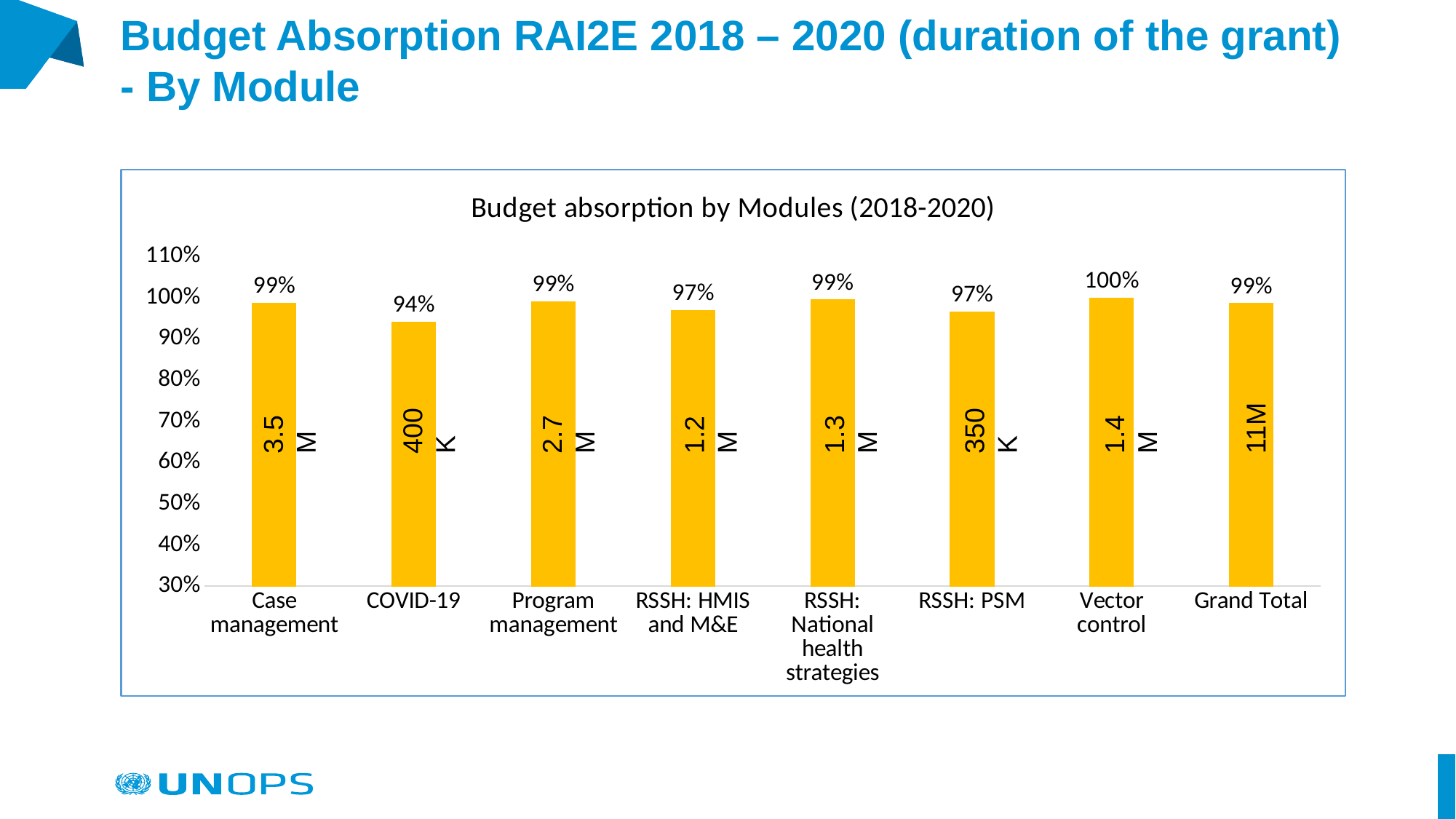
What is the budget absorption percentage for the Grand Total? 99% What is the difference in budget absorption percentage between Vector control and COVID-19? 6% How many categories are shown on the x axis of the chart? 8 Which module has the lowest budget absorption percentage? COVID-19 What is the budget absorption percentage for RSSH: PSM? 97% What is the title of the chart? Budget absorption by Modules (2018-2020) What is the budget absorption percentage for COVID-19? 94% Which category has the highest budget absorption percentage? Vector control Is the budget absorption for COVID-19 greater or less than 90%? greater Which has a higher budget absorption percentage, Case management or RSSH: HMIS and M&E? Case management What is the budget absorption percentage for Vector control? 100% What kind of chart is shown on the slide? Bar chart